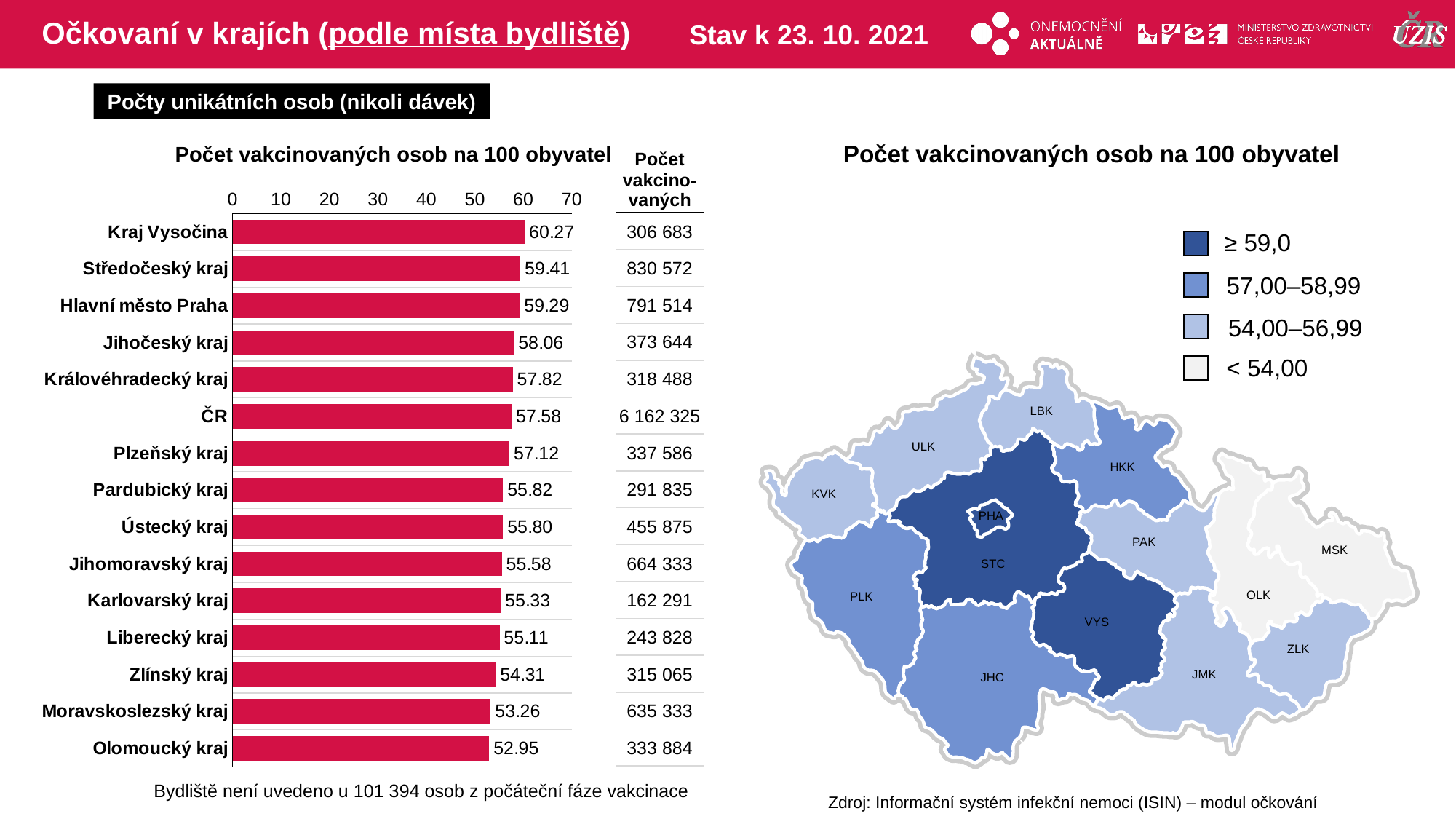
In the bar chart, what is the difference between the values for Kraj Vysočina and Olomoucký kraj? 7.32 In the bar chart, what is the value for ČR? 57.58 What is the title of the bar chart on the left? Počet vakcinovaných osob na 100 obyvatel How many categories (bars) are shown in the bar chart? 15 In the bar chart, what is the value for Olomoucký kraj? 52.95 Which category has the highest value in the bar chart? Kraj Vysočina What kind of chart is used on the left side of the slide? bar chart In the bar chart, which is larger: the value for Plzeňský kraj or the value for Pardubický kraj? Plzeňský kraj Which category has the lowest value in the bar chart? Olomoucký kraj In the bar chart, what is the value for Kraj Vysočina? 60.27 In the bar chart, is the value for Moravskoslezský kraj greater or less than 60? less In the bar chart, what is the difference between the values for Středočeský kraj and Hlavní město Praha? 0.12